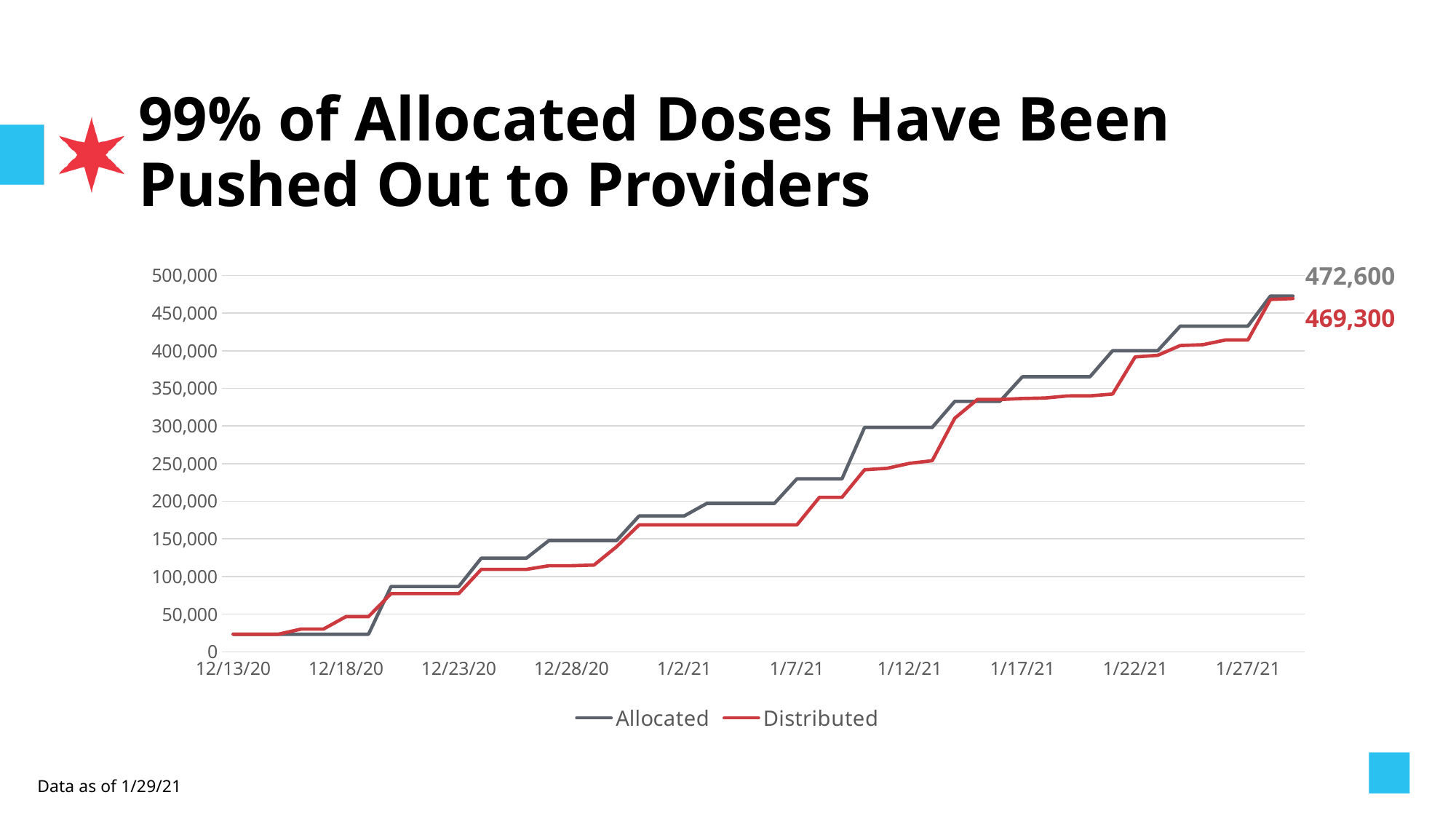
What is the difference between the final Allocated value and the final Distributed value? 3,300 What colour is the line for the Distributed series? Red Which series has the higher final value, Allocated or Distributed? Allocated What is the final value shown for the Allocated series? 472,600 What is the final value shown for the Distributed series? 469,300 Is the Allocated value on 12/23/20 greater or less than 100,000? less Do the values for the Allocated series rise or fall over time along the x axis? Rise What is the title of the slide? 99% of Allocated Doses Have Been Pushed Out to Providers What kind of chart is shown on the slide? Line chart Is the Distributed value on 1/2/21 greater or less than 200,000? less How many series does the legend list? 2 Is the Allocated value on 1/12/21 greater or less than 250,000? greater